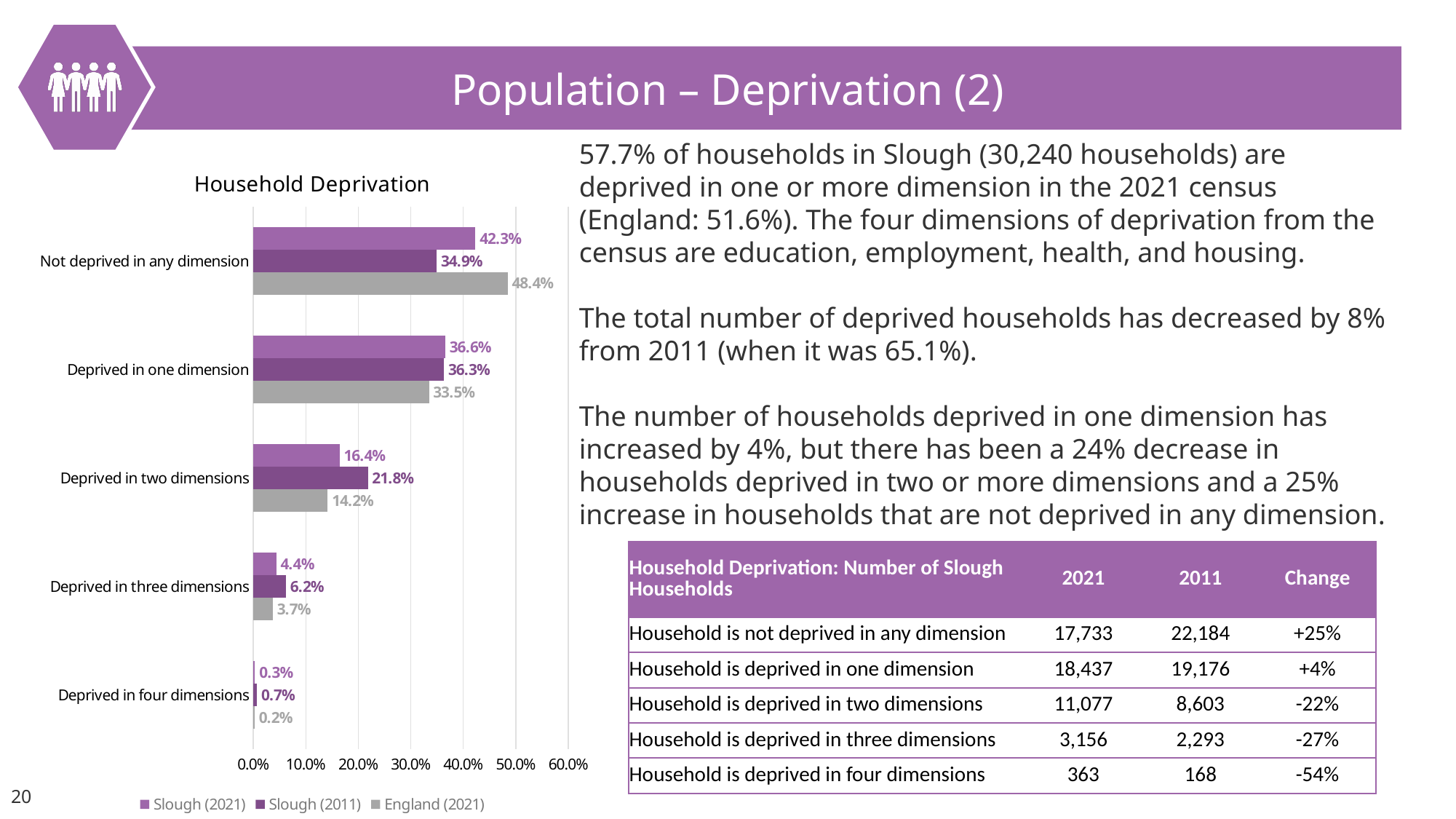
Which category has the highest Slough (2021) value in the Household Deprivation chart? Not deprived in any dimension What is the Slough (2021) value for 'Deprived in two dimensions' in the Household Deprivation chart? 16.4% What is the Slough (2011) value for 'Deprived in three dimensions' in the Household Deprivation chart? 6.2% Is the Slough (2011) value for 'Not deprived in any dimension' greater or less than 40.0%? less How many categories are shown in the Household Deprivation chart? 5 Which category has the lowest England (2021) value in the Household Deprivation chart? Deprived in four dimensions What type of chart is the Household Deprivation chart? Bar chart What is the England (2021) value for 'Not deprived in any dimension' in the Household Deprivation chart? 48.4% What is the title of the chart on the slide? Household Deprivation For 'Deprived in one dimension', which is larger: the Slough (2021) value or the England (2021) value? Slough (2021) How many series does the legend of the Household Deprivation chart list? 3 What is the difference between the Slough (2021) and Slough (2011) values for 'Deprived in two dimensions'? 5.4%